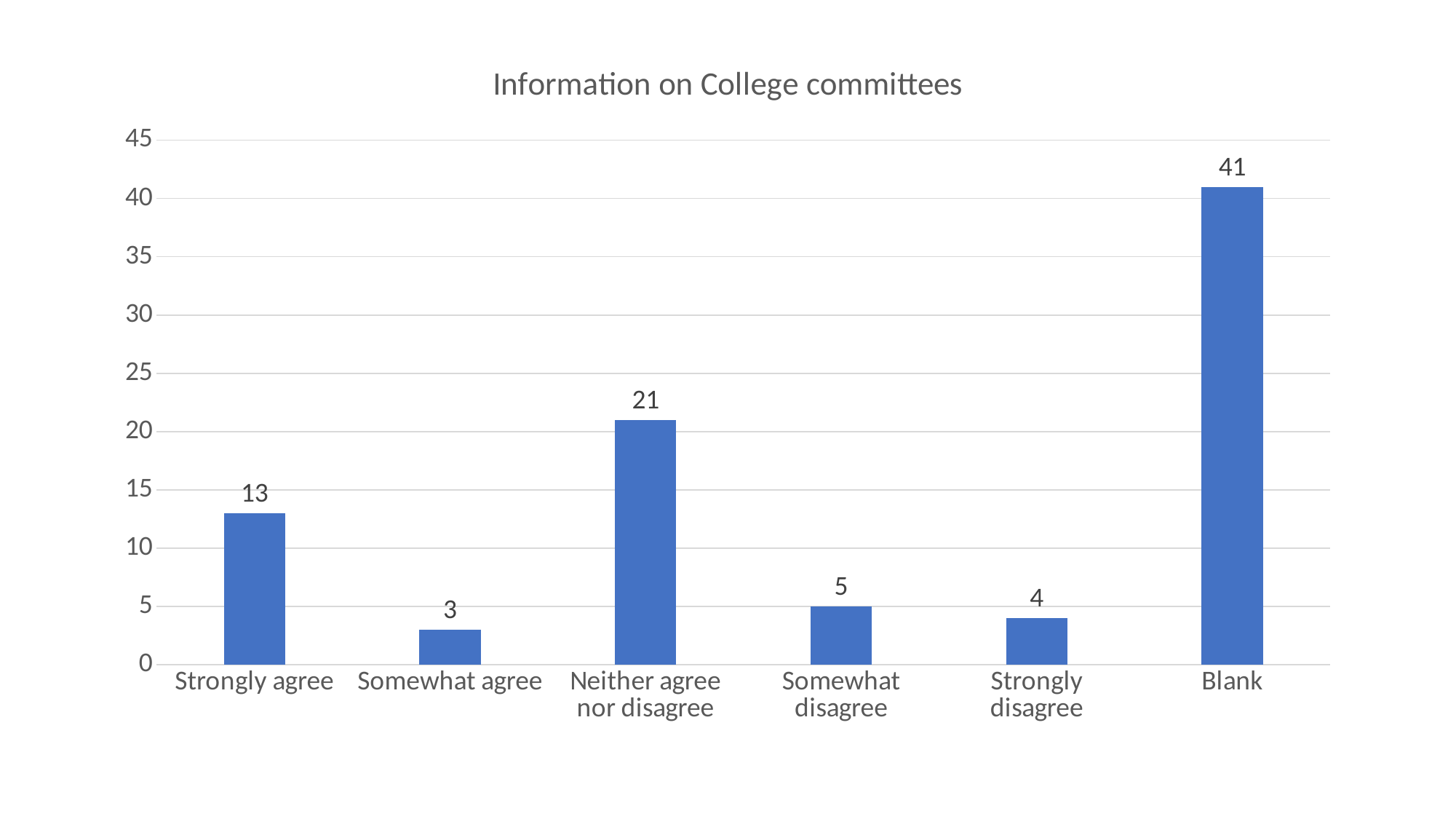
Which category has the highest value? Blank Which category has the lowest value? Somewhat agree How many categories are shown on the x axis? 6 What is the difference between the values for Strongly agree and Strongly disagree? 9 What is the value for Strongly agree? 13 What is the value for Neither agree nor disagree? 21 Which is larger, the value for Strongly agree or the value for Somewhat disagree? Strongly agree What is the value for Somewhat disagree? 5 What is the title of the chart? Information on College committees What kind of chart is this? Bar chart What is the value for Blank? 41 What is the difference between the values for Blank and Neither agree nor disagree? 20